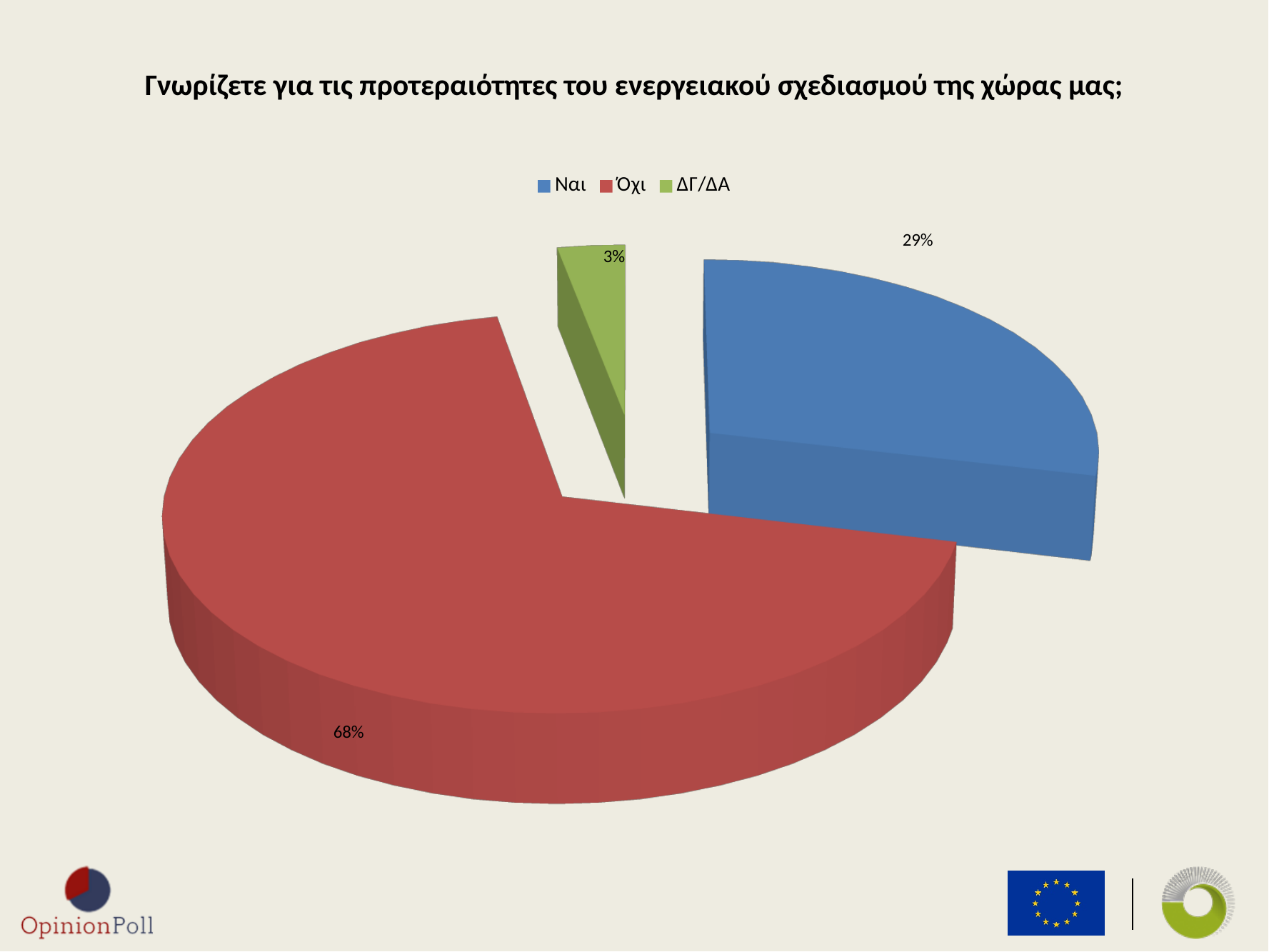
What is the title of the chart? Γνωρίζετε για τις προτεραιότητες του ενεργειακού σχεδιασμού της χώρας μας; Which is larger, the share for Ναι or the share for ΔΓ/ΔΑ? Ναι What is the difference in percentage points between Όχι and Ναι? 39 How many slices does the pie chart have? 3 What colour is the slice for Όχι? Red What percentage of respondents answered Ναι? 29% How many entries does the legend list? 3 What kind of chart is shown on the slide? Pie chart What percentage of respondents answered ΔΓ/ΔΑ? 3% What percentage of respondents answered Όχι? 68% Which response has the largest share of the pie? Όχι Which response has the smallest share of the pie? ΔΓ/ΔΑ